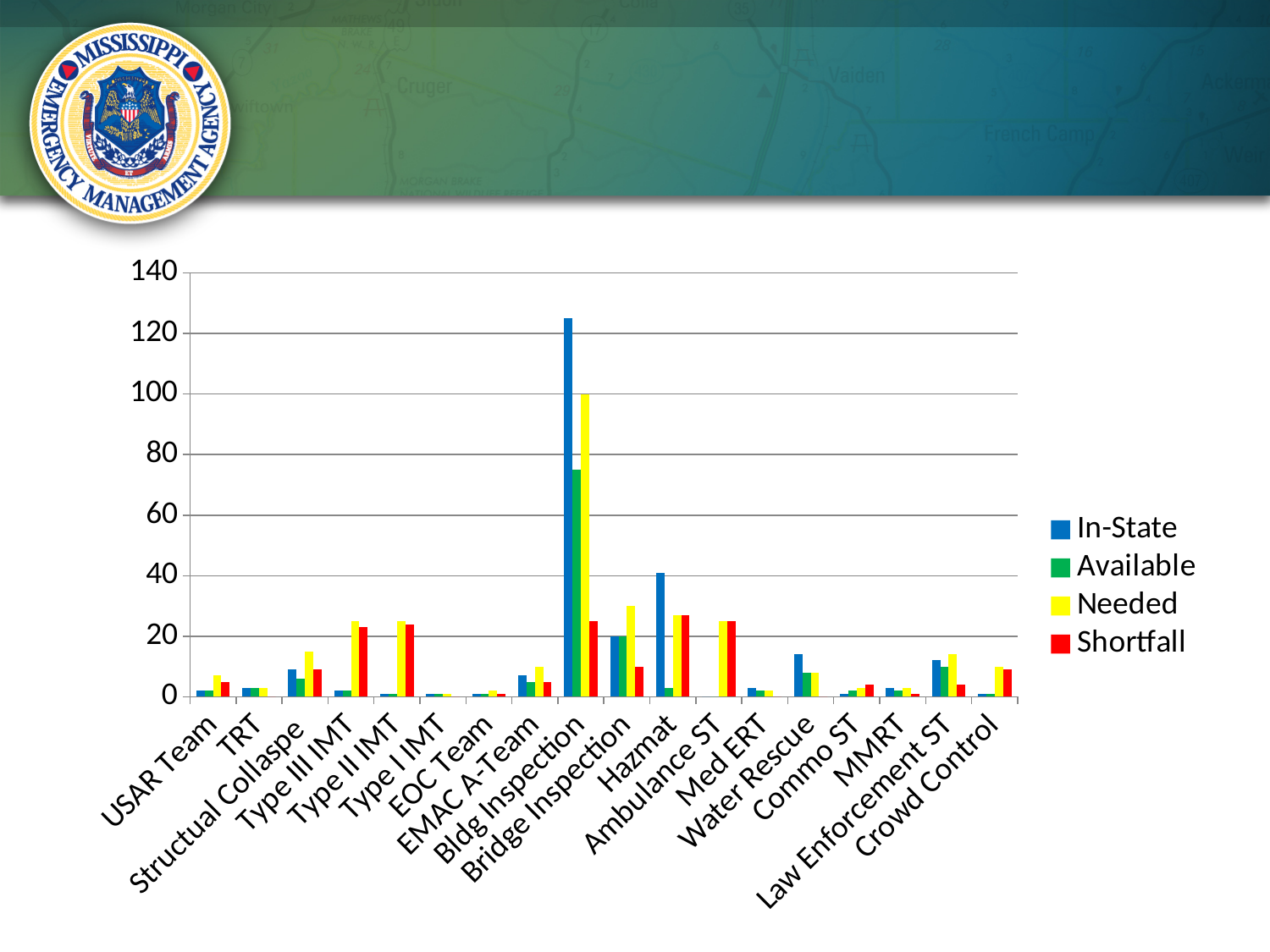
Which is larger for Bridge Inspection, the Needed value or the Shortfall value? Needed How many categories are shown on the x axis? 18 What kind of chart is shown on the slide? bar chart Is the In-State value for Hazmat greater or less than 20? greater How many series does the legend list? 4 Which series is shown in red in the legend? Shortfall Which category has the highest Needed value? Bldg Inspection Is the Available value for Bldg Inspection greater or less than 60? greater Which category has the highest In-State value? Bldg Inspection Is the In-State value for Bldg Inspection greater or less than 120? greater What is the Needed value for Bldg Inspection? 100 Which is larger, the In-State value for Bldg Inspection or the In-State value for Hazmat? Bldg Inspection